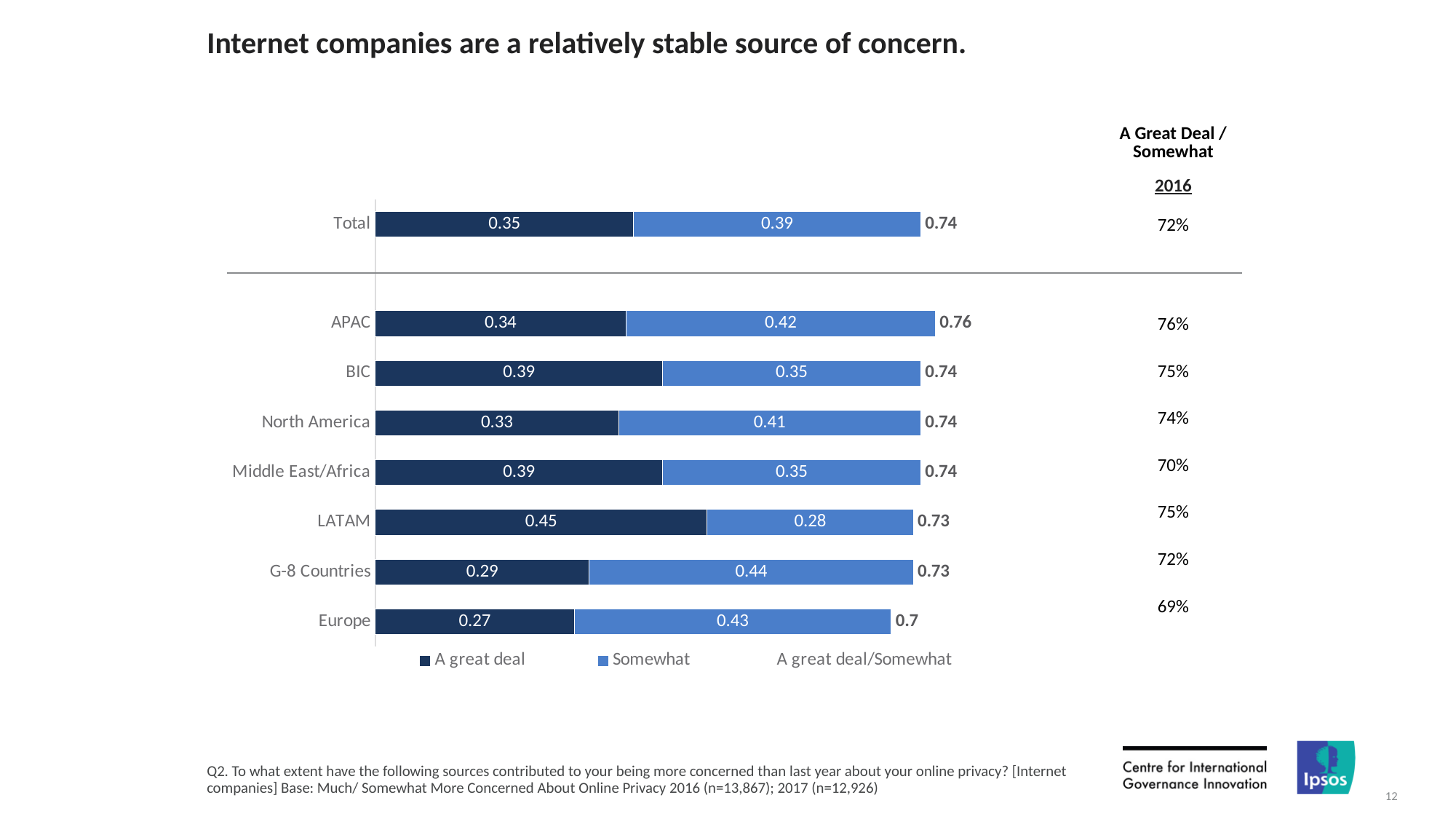
How many entries does the legend list? 3 Which region has the lowest 'A great deal' value? Europe What is the title of the slide? Internet companies are a relatively stable source of concern. What is the 2016 'A Great Deal / Somewhat' percentage shown for Middle East/Africa? 70% What is the 'A great deal' value for LATAM? 0.45 What is the combined 'A great deal/Somewhat' value shown for Europe? 0.7 What kind of chart is shown on the slide? Stacked bar chart What is the difference between the 'Somewhat' values for APAC and LATAM? 0.14 Which is larger, the 'A great deal' value for BIC or for North America? BIC What is the 'Somewhat' value for G-8 Countries? 0.44 Which region has the highest 'A great deal' value? LATAM How many region categories are plotted below the Total bar? 7